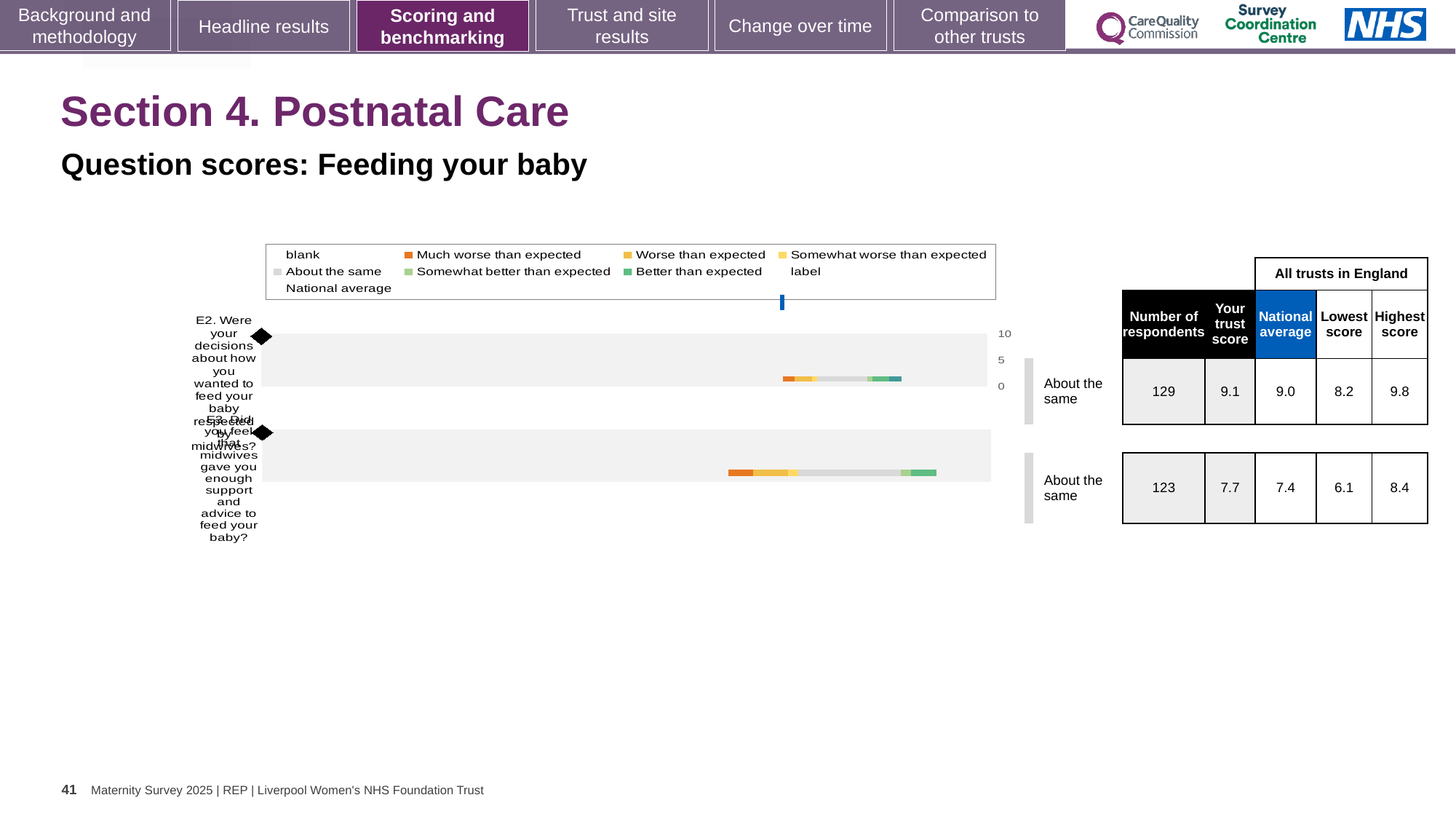
Which question has the higher trust score, E2 or E3? E2 How many questions (categories) are plotted on the chart? 2 What is the national average for question E3? 7.4 What is the trust score for question E2? 9.1 What is the lowest score across all trusts in England for question E3? 6.1 What kind of chart is shown on the slide? bar chart What is the benchmark category shown for question E2 (decisions about how you wanted to feed your baby respected by midwives)? About the same What is the difference between the trust score and the national average for question E3? 0.3 How many respondents answered question E2? 129 What is the trust score for question E3? 7.7 What is the benchmark category shown for question E3 (midwives gave you enough support and advice to feed your baby)? About the same What is the highest score across all trusts in England for question E2? 9.8